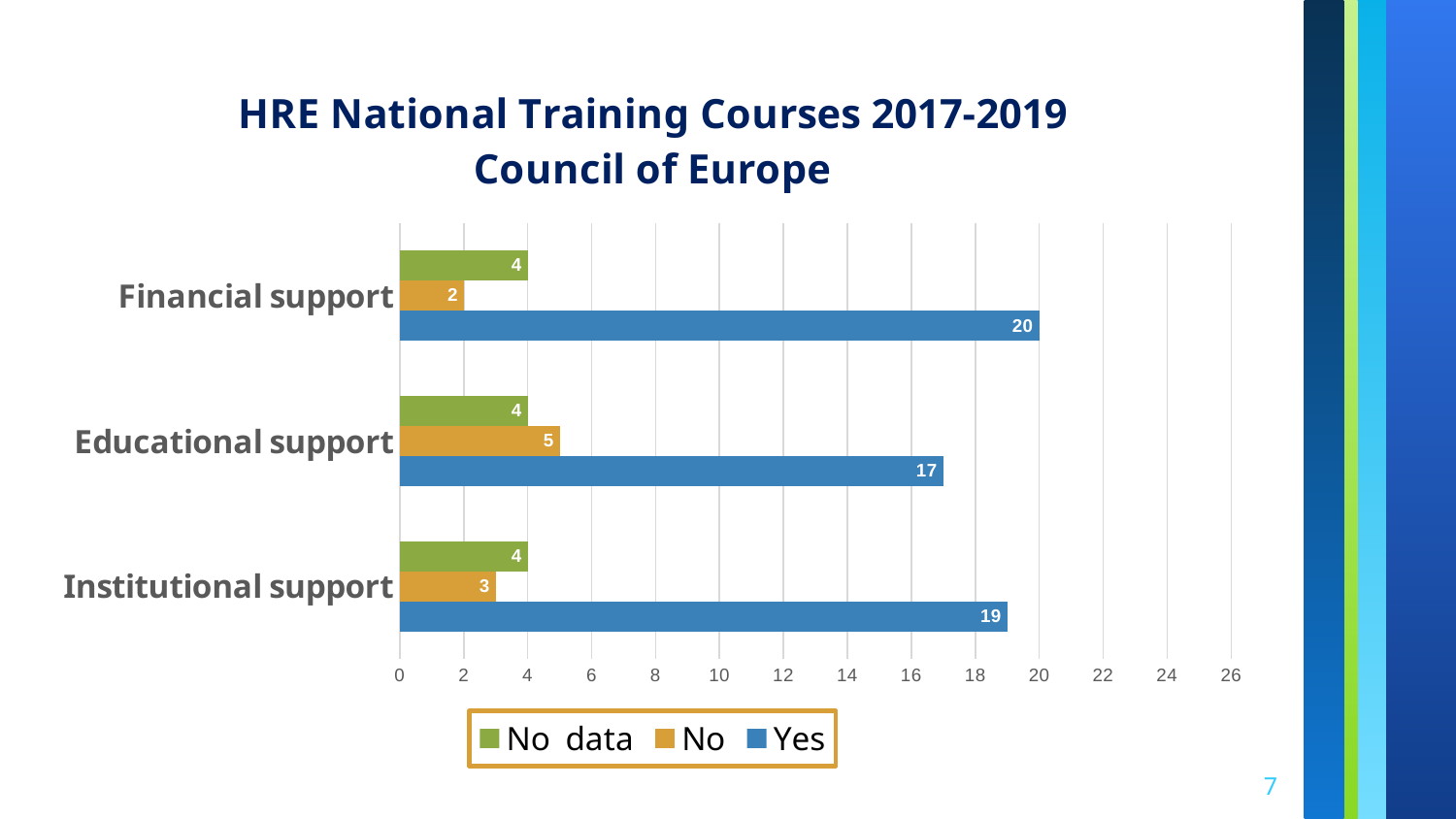
What is the difference between the Yes values for Financial support and Educational support? 3 What is the title of the chart? HRE National Training Courses 2017-2019 Council of Europe Which is larger: the No value for Educational support or the No value for Institutional support? Educational support What is the value for Yes for Financial support? 20 How many series does the legend list? 3 What is the value for No data for Institutional support? 4 Which category has the lowest No value? Financial support How many categories are shown on the chart? 3 Which category has the highest Yes value? Financial support What kind of chart is shown on the slide? bar chart Is the Yes value for Institutional support greater or less than 10? greater What is the value for No for Educational support? 5